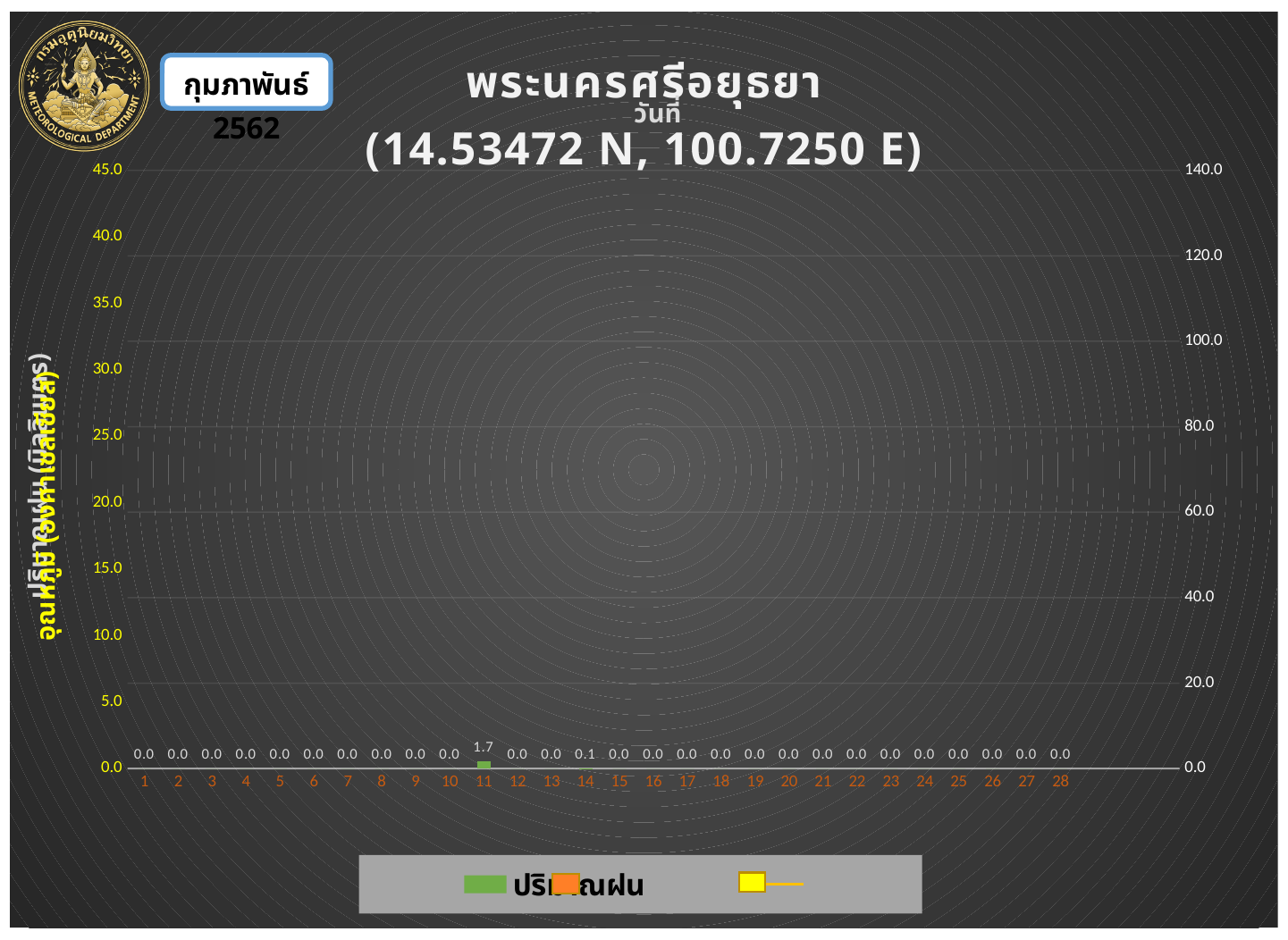
Which day has the highest rainfall value? 11 What is the rainfall value shown for day 1? 0.0 Is the rainfall value for day 11 greater or less than 5.0 on the left axis? less How many days are shown on the x axis? 28 What is the rainfall value shown for day 11? 1.7 What kind of chart is used to show the rainfall values? bar chart Which is larger, the rainfall value for day 11 or for day 14? day 11 What is the rainfall value shown for day 28? 0.0 What is the highest tick value on the right-hand axis? 140.0 What coordinates are given in the chart title? 14.53472 N, 100.7250 E What is the rainfall value shown for day 14? 0.1 What is the difference between the rainfall values for day 11 and day 14? 1.6